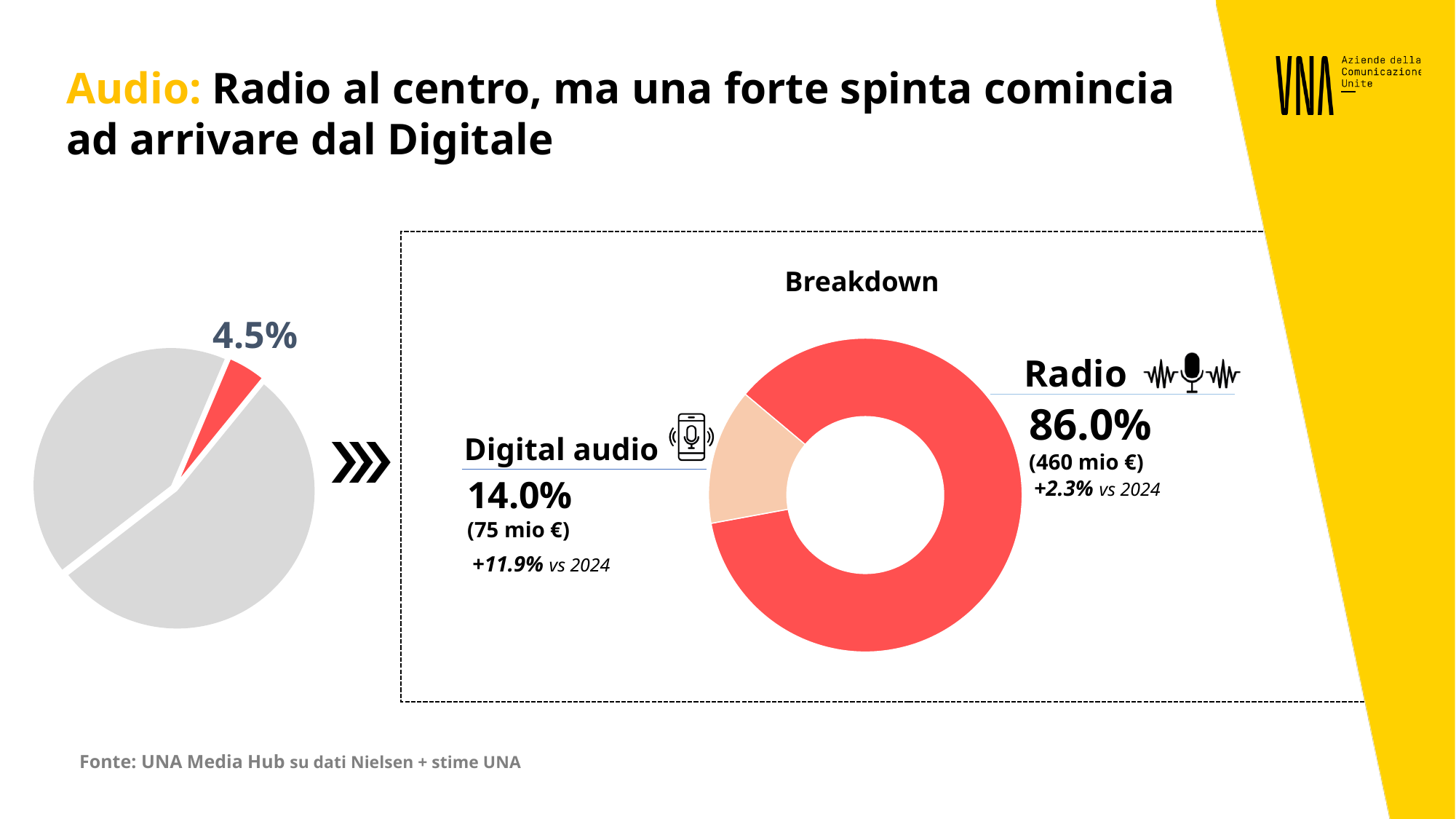
In the Breakdown donut chart, how many segments are shown? 2 In the Breakdown donut chart, what is the value in mio € shown for Digital audio? 75 mio € In the Breakdown donut chart, what is the difference in percentage points between Radio and Digital audio? 72.0 percentage points In the Breakdown donut chart, what share does Radio account for? 86.0% In the Breakdown donut chart, what is the change vs 2024 shown for Digital audio? +11.9% In the Breakdown donut chart, what is the change vs 2024 shown for Radio? +2.3% In the Breakdown donut chart, which segment is the smallest? Digital audio What kind of chart is the Breakdown chart on the right? Donut chart In the Breakdown donut chart, what is the value in mio € shown for Radio? 460 mio € In the Breakdown donut chart, what share does Digital audio account for? 14.0% What percentage is labelled on the highlighted slice of the pie chart on the left of the slide? 4.5% In the Breakdown donut chart, which segment is the largest? Radio